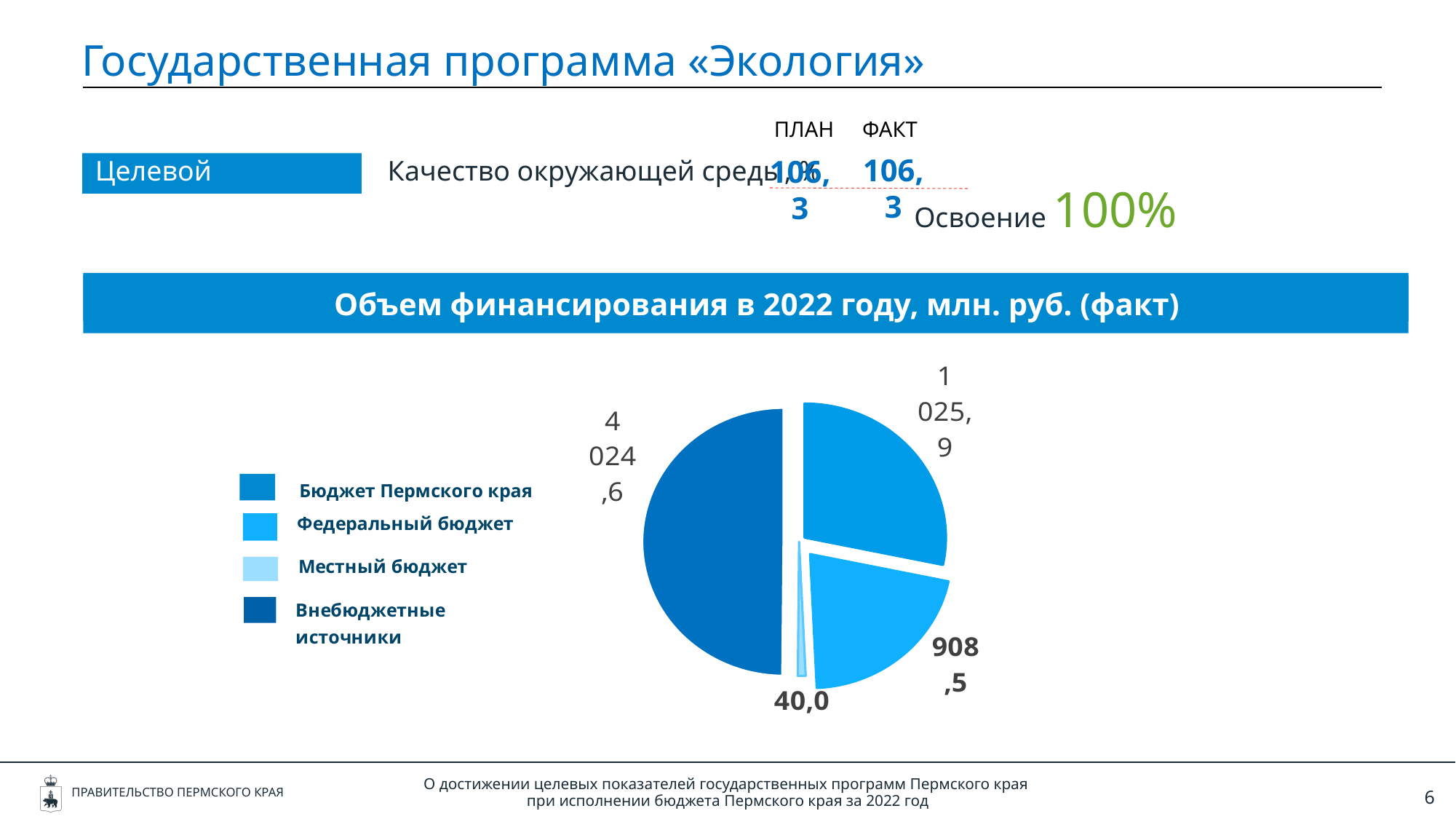
What is the value for «Федеральный бюджет» in the pie chart? 908,5 What is the difference between «Внебюджетные источники» and «Бюджет Пермского края» in the pie chart? 2 998,7 What is the value for «Внебюджетные источники» in the pie chart? 4 024,6 Which funding source has the smallest slice in the pie chart? Местный бюджет How many slices does the pie chart have? 4 Which is larger in the pie chart: «Бюджет Пермского края» or «Федеральный бюджет»? Бюджет Пермского края What is the value for «Бюджет Пермского края» in the pie chart? 1 025,9 What is the title of the section containing the pie chart? Объем финансирования в 2022 году, млн. руб. (факт) What is the difference between «Бюджет Пермского края» and «Федеральный бюджет» in the pie chart? 117,4 Which funding source has the largest slice in the pie chart? Внебюджетные источники What kind of chart is shown under the heading «Объем финансирования в 2022 году, млн. руб. (факт)»? Pie chart What is the value for «Местный бюджет» in the pie chart? 40,0